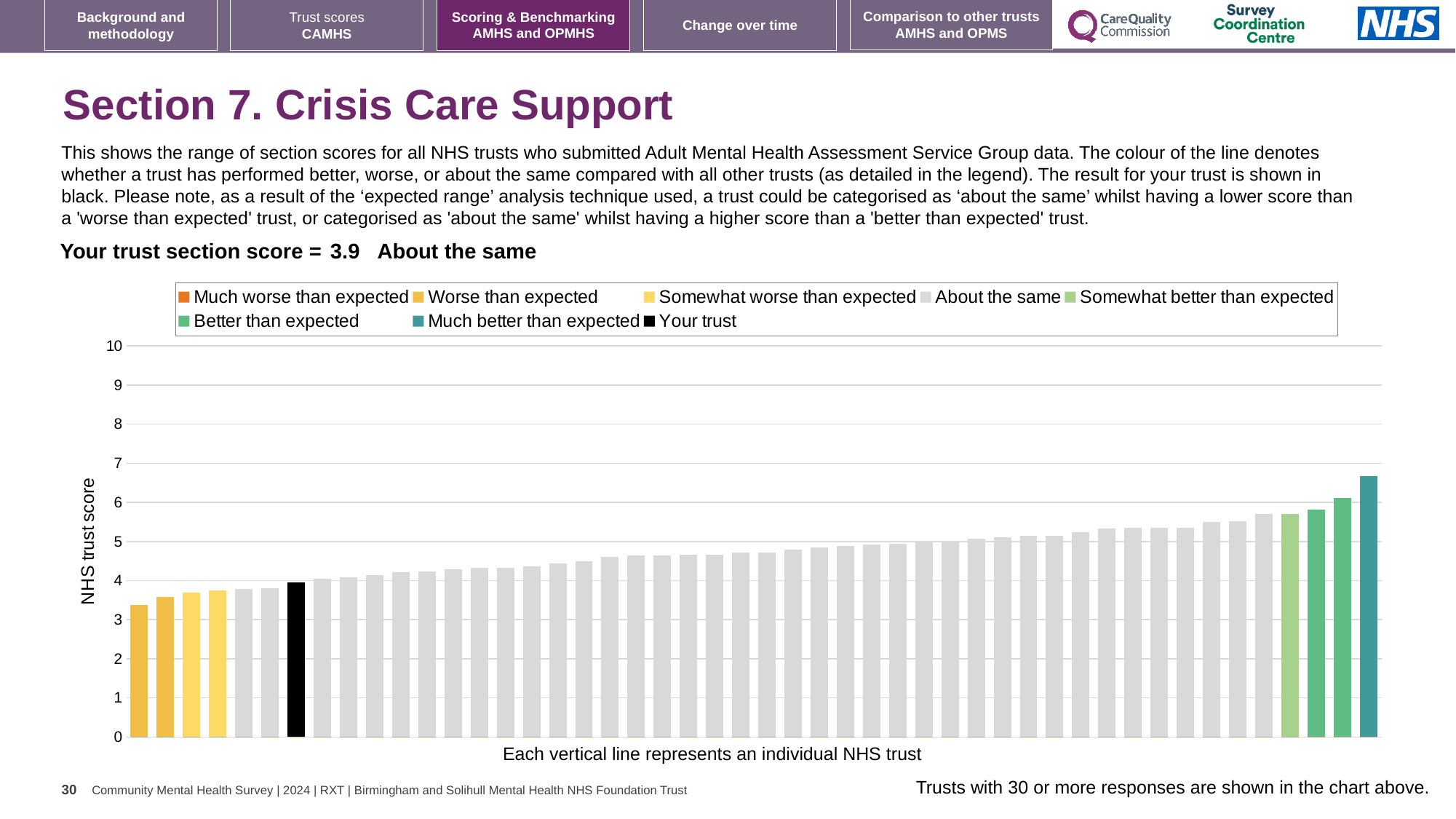
What kind of chart is shown on the slide? bar chart How many bars in the chart are in the 'Much better than expected' category? 1 How many entries does the chart legend list? 8 Which legend category does the tallest bar in the chart belong to? Much better than expected What is the label on the vertical axis of the chart? NHS trust score Is the value of the tallest bar in the chart greater or less than 6? greater Which performance category is your trust placed in for Crisis Care Support? About the same Is the value of the shortest bar in the chart greater or less than 4? less Do the bar values rise or fall from left to right along the x axis? rise Which is larger: the value of the tallest bar or the value for your trust? the tallest bar What is the section score for your trust shown on the slide? 3.9 Is the value for your trust (the black bar) greater or less than 3? greater